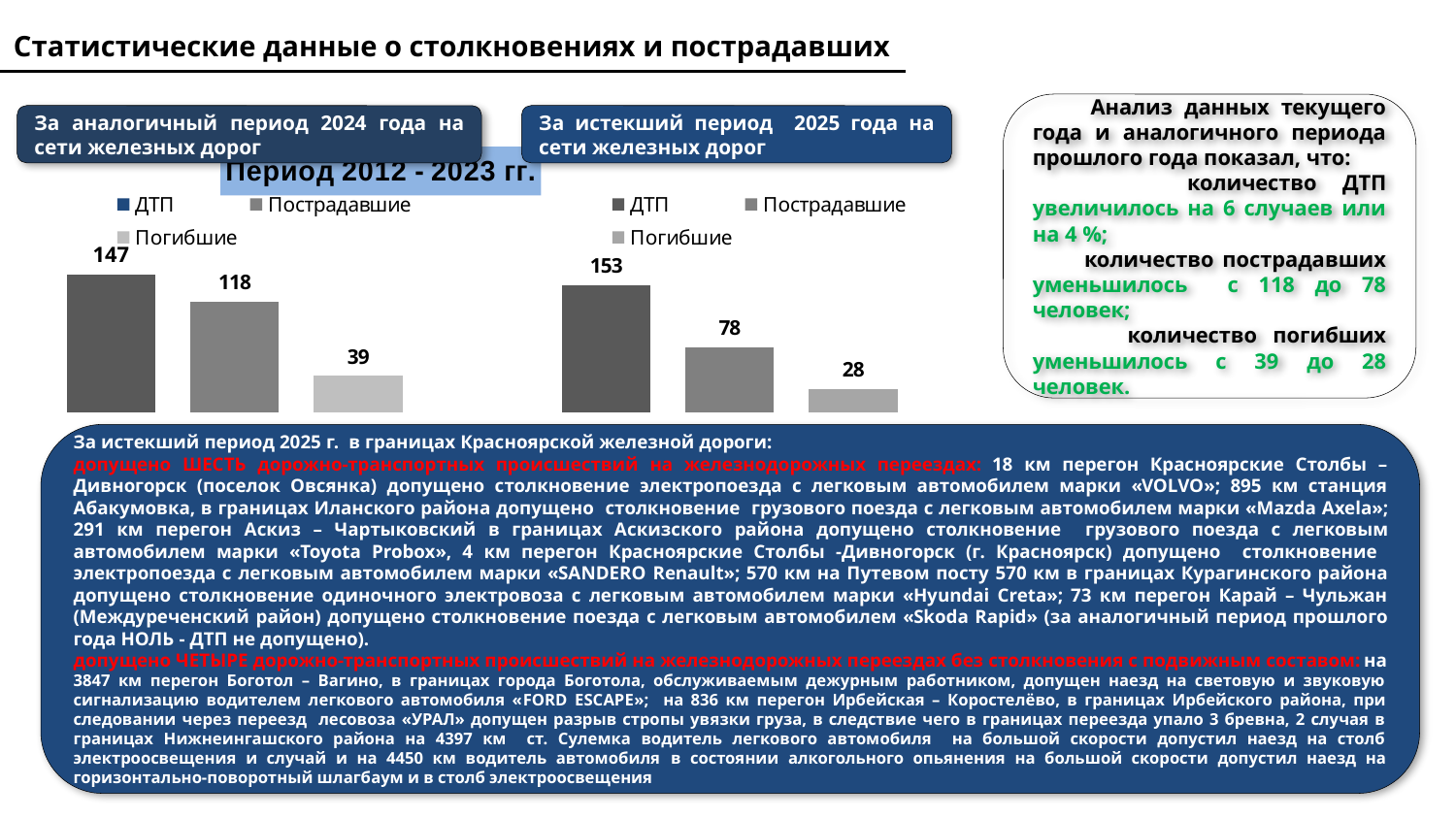
In the left chart (2024 period), what is the value for Погибшие? 39 In the right chart (2025 period), what is the value for ДТП? 153 What type of chart is the right chart (2025 period)? Bar chart In the right chart (2025 period), what is the difference between ДТП and Пострадавшие? 75 In the left chart (2024 period), what is the value for ДТП? 147 Which is larger: Пострадавшие in the left chart (2024) or Пострадавшие in the right chart (2025)? Пострадавшие in the left chart (2024), 118 In the right chart (2025 period), which series has the highest value? ДТП How many series does the legend of the left chart (2024 period) list? 3 In the left chart (2024 period), which series has the lowest value? Погибшие In the right chart (2025 period), what is the value for Погибшие? 28 In the left chart (2024 period), what is the value for Пострадавшие? 118 In the right chart (2025 period), what is the value for Пострадавшие? 78